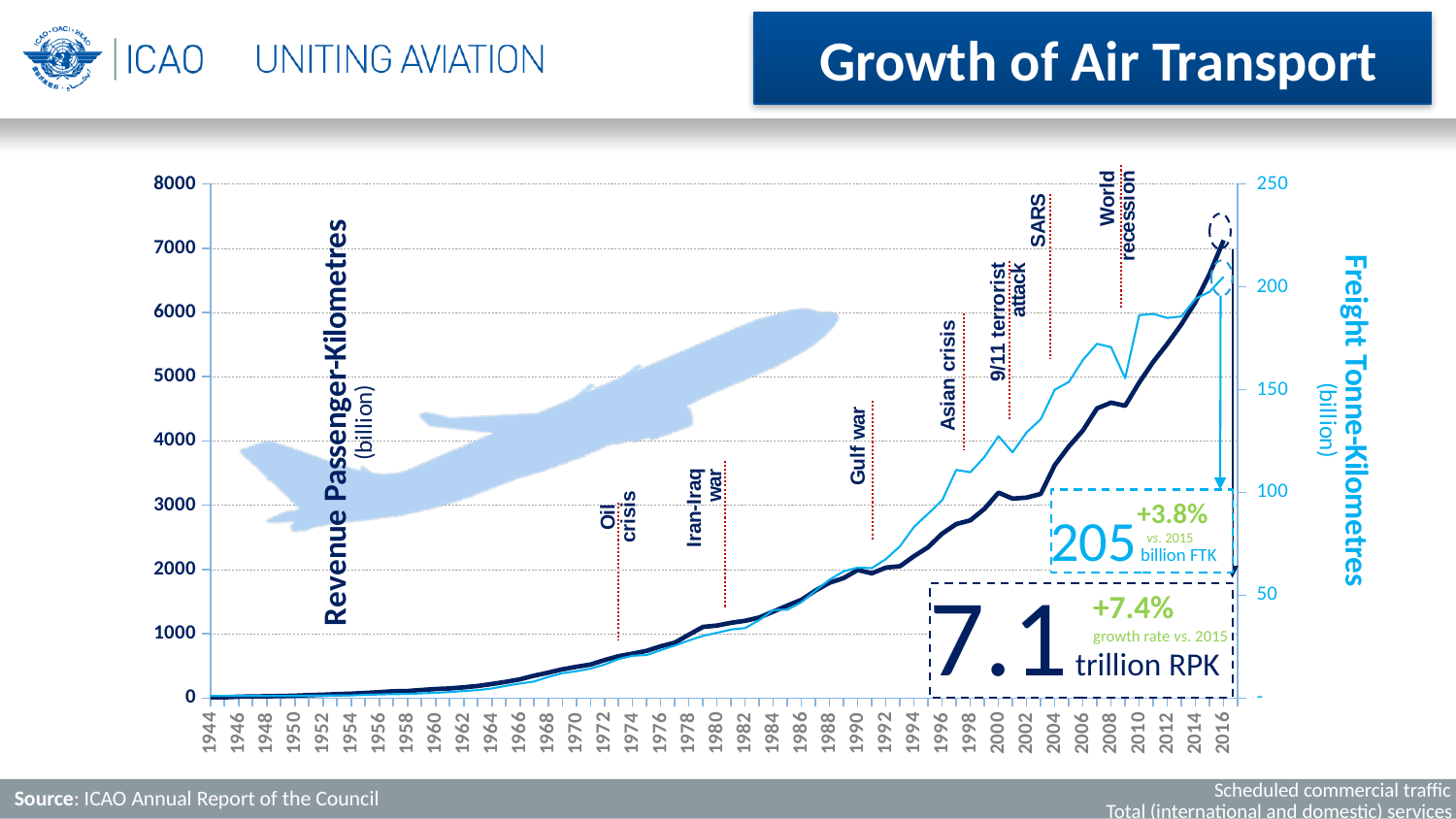
Is the Revenue Passenger-Kilometres value for 1990 greater or less than 3000? less Is the Revenue Passenger-Kilometres value for 2000 greater or less than 4000? less What is the title of the right vertical axis? Freight Tonne-Kilometres (billion) What is the Revenue Passenger-Kilometres value highlighted for 2016? 7.1 trillion RPK What growth rate vs. 2015 is shown for RPK? +7.4% What kind of chart is shown on the slide? line chart What growth vs. 2015 is shown for FTK? +3.8% Which year has the higher Revenue Passenger-Kilometres value, 1980 or 2016? 2016 Do the Revenue Passenger-Kilometres values rise or fall from 1944 to 2016? rise What is the first year shown on the x axis? 1944 What is the Freight Tonne-Kilometres value highlighted for 2016? 205 billion FTK What is the title of the left vertical axis? Revenue Passenger-Kilometres (billion)